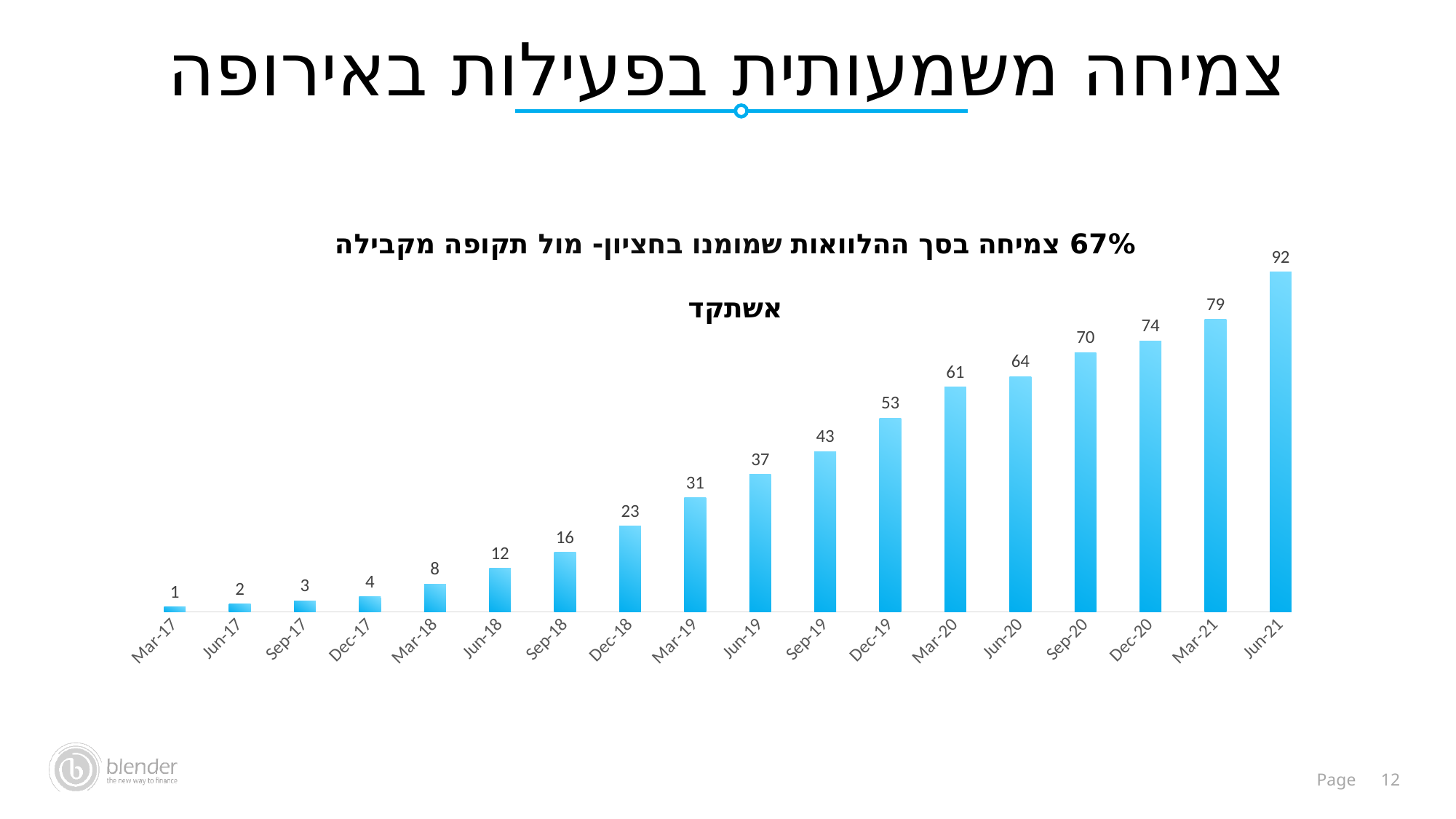
How many periods are shown on the x axis? 18 What is the difference between the values for Jun-21 and Mar-21? 13 What kind of chart is this? bar chart Which period has the lowest value? Mar-17 What is the value for Mar-20? 61 What percentage growth is stated in the text above the chart? 67% What is the value for Dec-18? 23 Which is larger, the value for Sep-19 or the value for Jun-20? Jun-20 Do the values rise or fall from Mar-17 to Jun-21? rise Which period has the highest value? Jun-21 What is the difference between the values for Dec-19 and Dec-18? 30 What is the value for Jun-21? 92